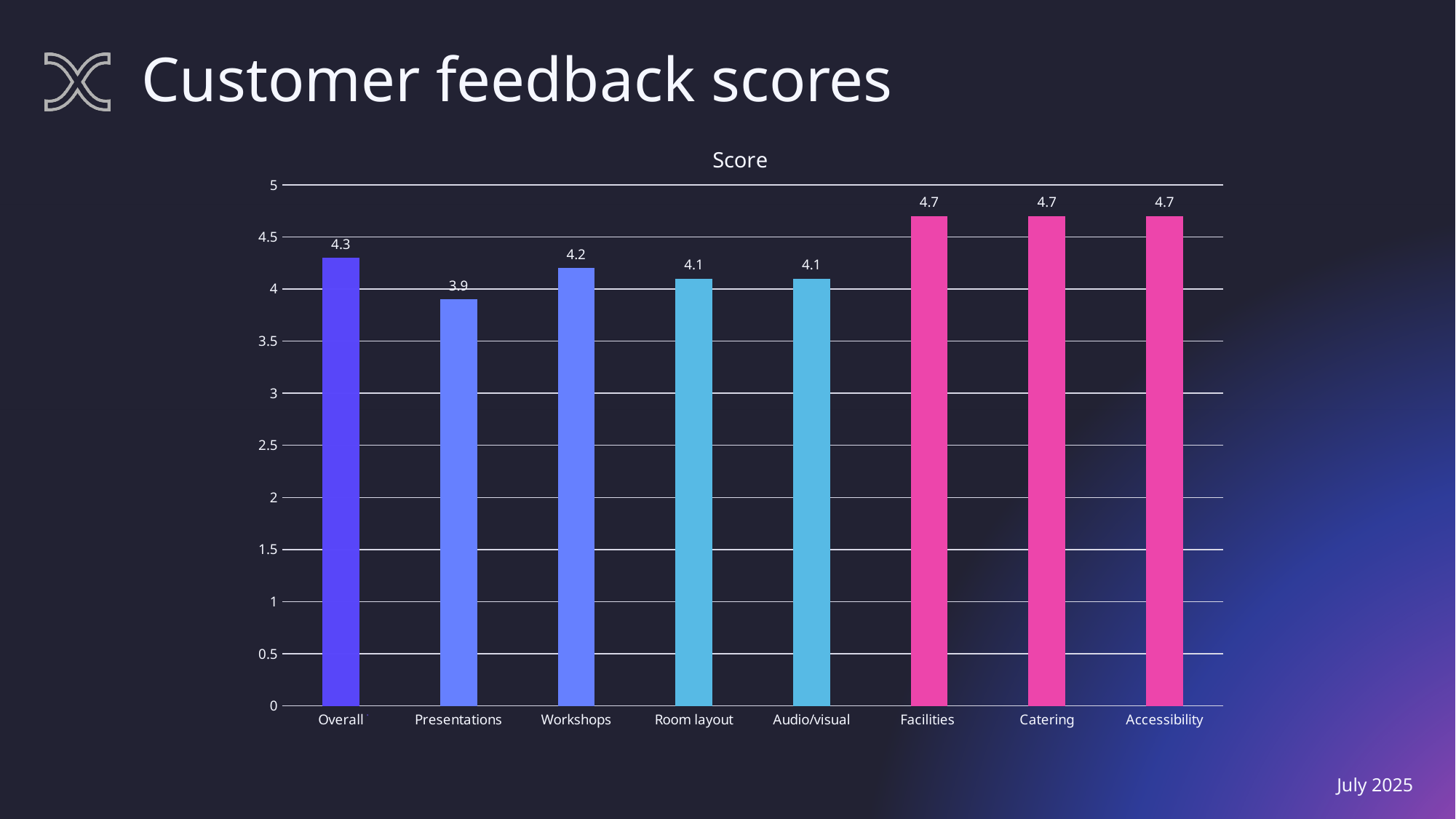
What is the score for Overall? 4.3 What is the score for Presentations? 3.9 Which category has the lowest score? Presentations What kind of chart is shown on the slide? Bar chart What is the score for Workshops? 4.2 What colour are the bars for Facilities, Catering and Accessibility? Pink Is the score for Audio/visual greater or less than 4.5? less What is the difference between the Facilities score and the Presentations score? 0.8 What is the title of the chart? Score Which is larger, the score for Catering or the score for Room layout? Catering How many categories are shown on the chart? 8 What is the difference between the Overall score and the Workshops score? 0.1